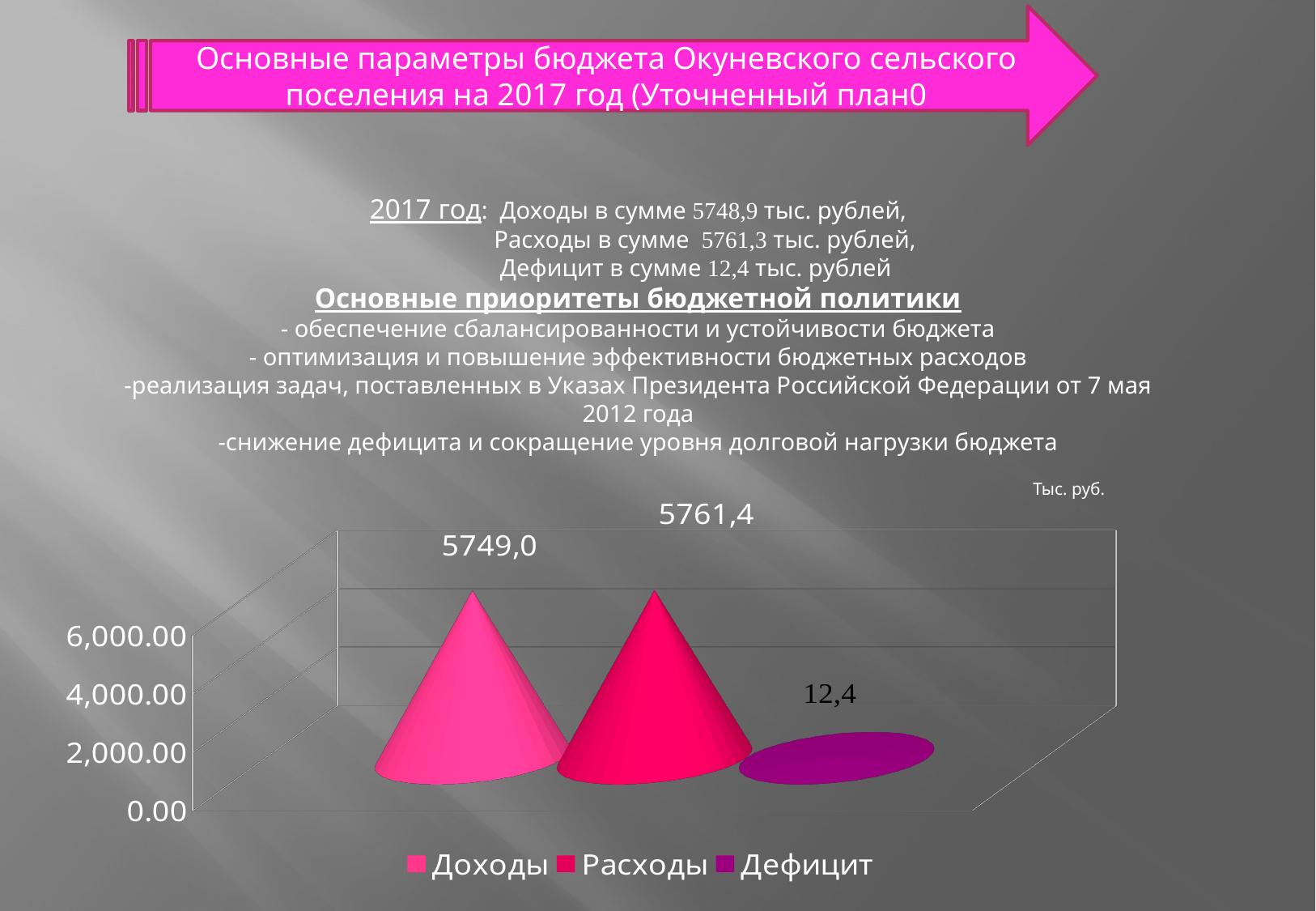
How many series does the chart legend list? 3 What is the value shown for Дефицит on the chart? 12,4 Which is larger on the chart, Доходы or Дефицит? Доходы What is the difference between the values for Расходы and Доходы on the chart? 12,4 What kind of chart is shown on the slide? bar chart Which series has the lowest value on the chart? Дефицит Which series has the highest value on the chart? Расходы What is the value shown for Доходы on the chart? 5749,0 Is the value for Доходы greater or less than 4,000.00? greater Is the value for Дефицит greater or less than 2,000.00? less What is the value shown for Расходы on the chart? 5761,4 What unit label is shown above the chart? Тыс. руб.